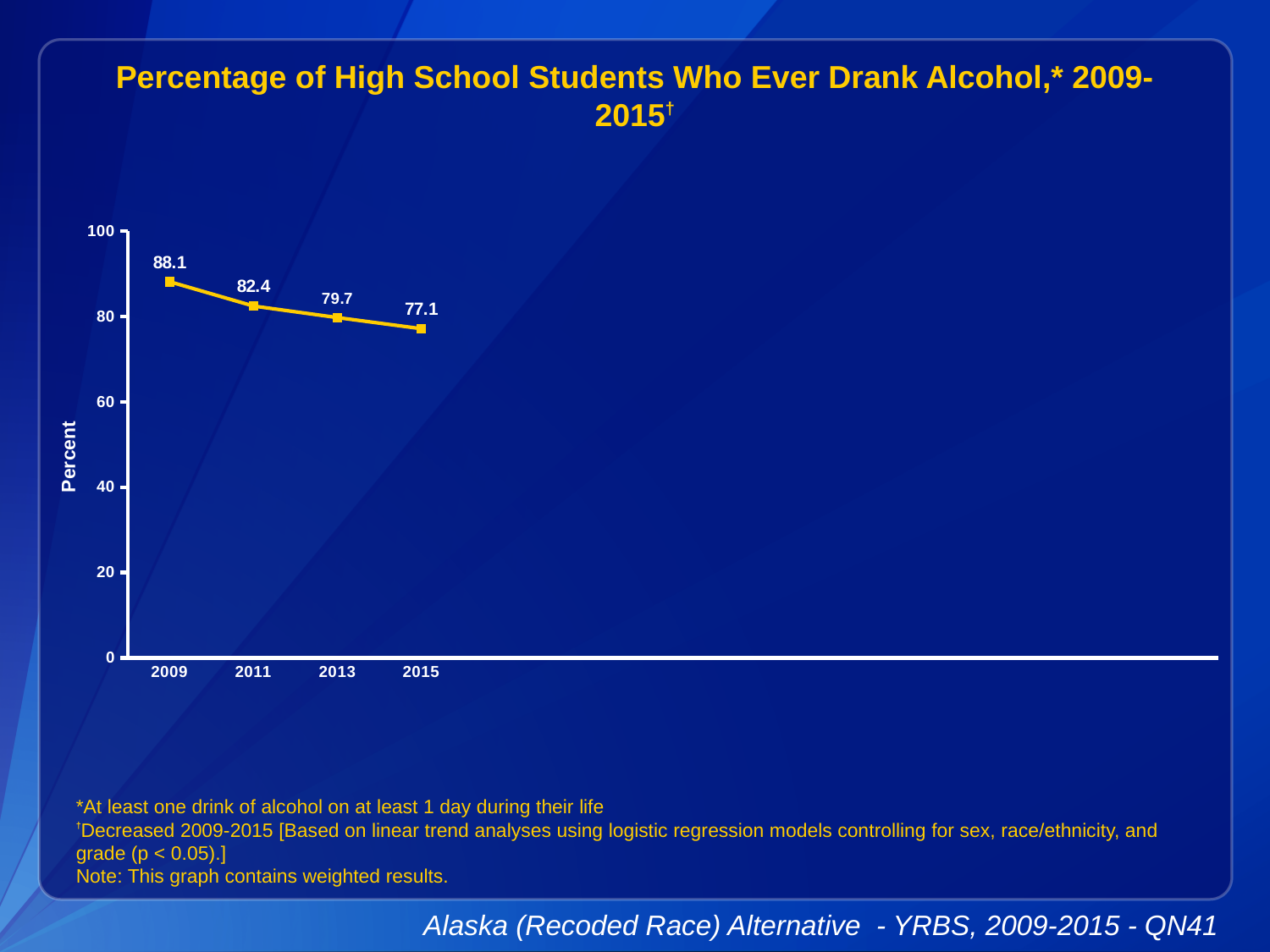
Is the value for 2013 greater or less than 60? greater Which year has the lowest percentage? 2015 What is the percentage of high school students who ever drank alcohol in 2009? 88.1 Which year has the highest percentage? 2009 What is the value plotted for 2015? 77.1 How many years are plotted on the chart? 4 Which is larger, the value for 2013 or the value for 2015? 2013 What is the difference between the 2009 value and the 2015 value? 11 What is the value plotted for 2011? 82.4 What is the difference between the 2011 value and the 2013 value? 2.7 Do the values rise or fall from 2009 to 2015? fall What kind of chart is shown on the slide? line chart